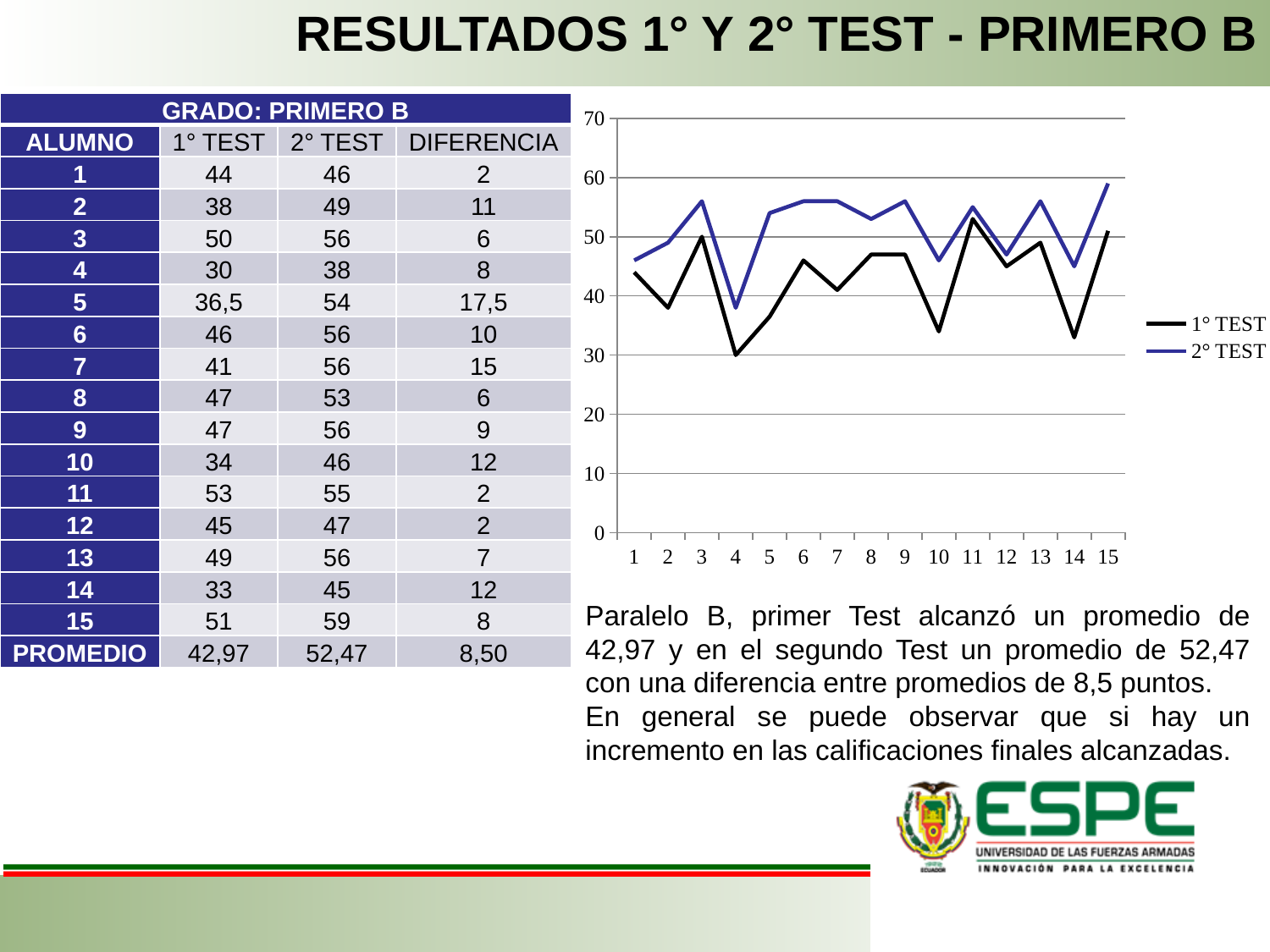
Which series is drawn with the blue line in the chart? 2° TEST What is the 1° TEST value for student 4? 30 How many students (points) are plotted along the x axis of the chart? 15 How many series does the chart legend list? 2 What is the 2° TEST value for student 15? 59 Which student has the lowest 1° TEST value? 4 Which student has the highest 2° TEST value? 15 Is the 1° TEST value for student 10 greater or less than 40? less What is the difference between the 2° TEST and 1° TEST values for student 5? 17,5 What kind of chart is shown on the slide? line chart For student 4, which series has the higher value, 1° TEST or 2° TEST? 2° TEST Is the 2° TEST value for student 7 greater or less than 50? greater